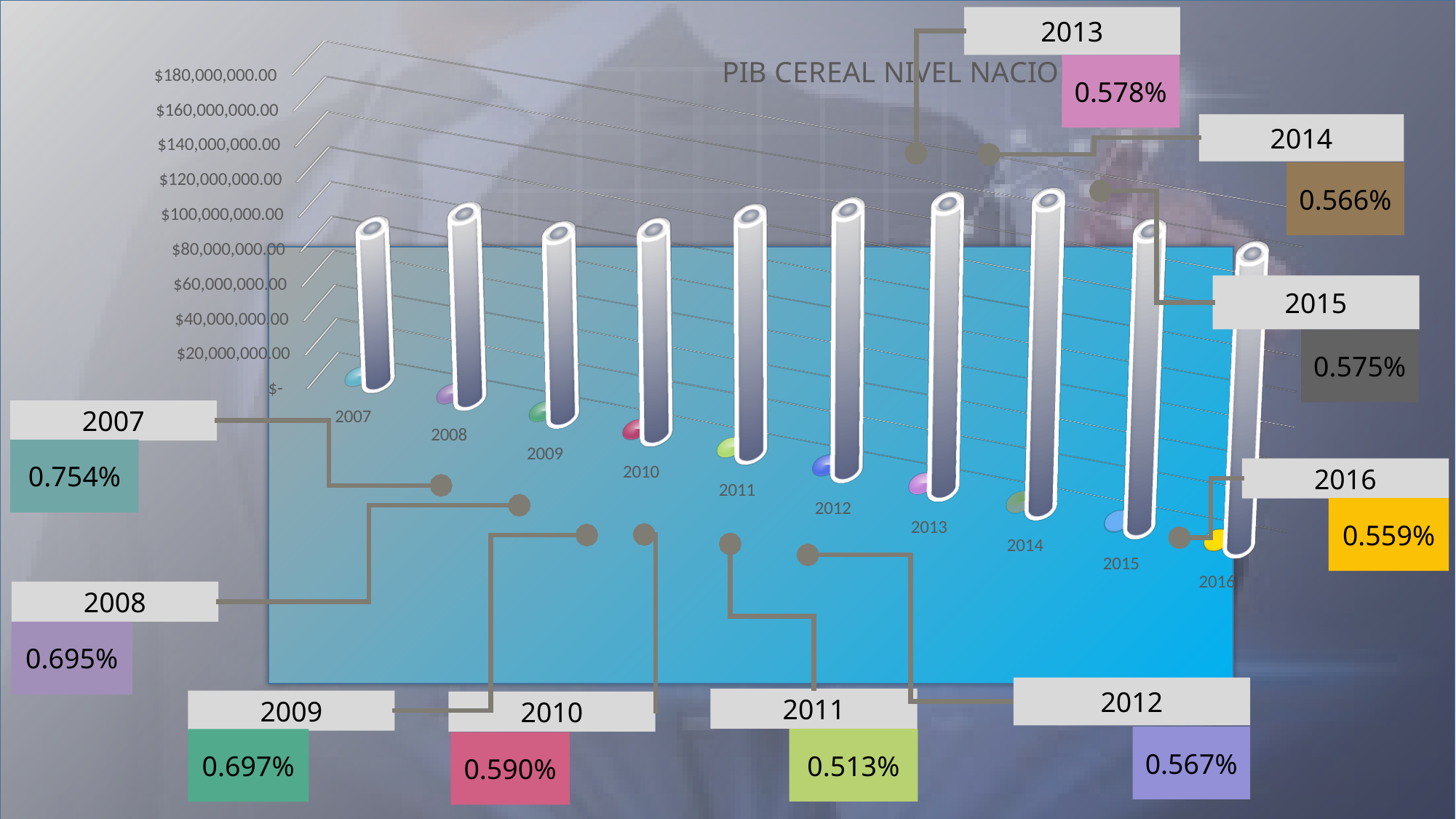
What percentage is shown in the callout box for 2016? 0.559% What percentage is shown in the callout box for 2013? 0.578% What kind of chart is shown on the slide? bar chart Which year has the lowest percentage in its callout box? 2011 What percentage is shown in the callout box for 2007? 0.754% What percentage is shown in the callout box for 2011? 0.513% What is the first year shown on the x axis of the chart? 2007 What is the highest value labelled on the vertical axis of the chart? $180,000,000.00 Which callout percentage is larger, the one for 2009 or the one for 2010? 2009 How many years are shown along the x axis of the chart? 10 What is the last year shown on the x axis of the chart? 2016 Which year has the highest percentage in its callout box? 2007